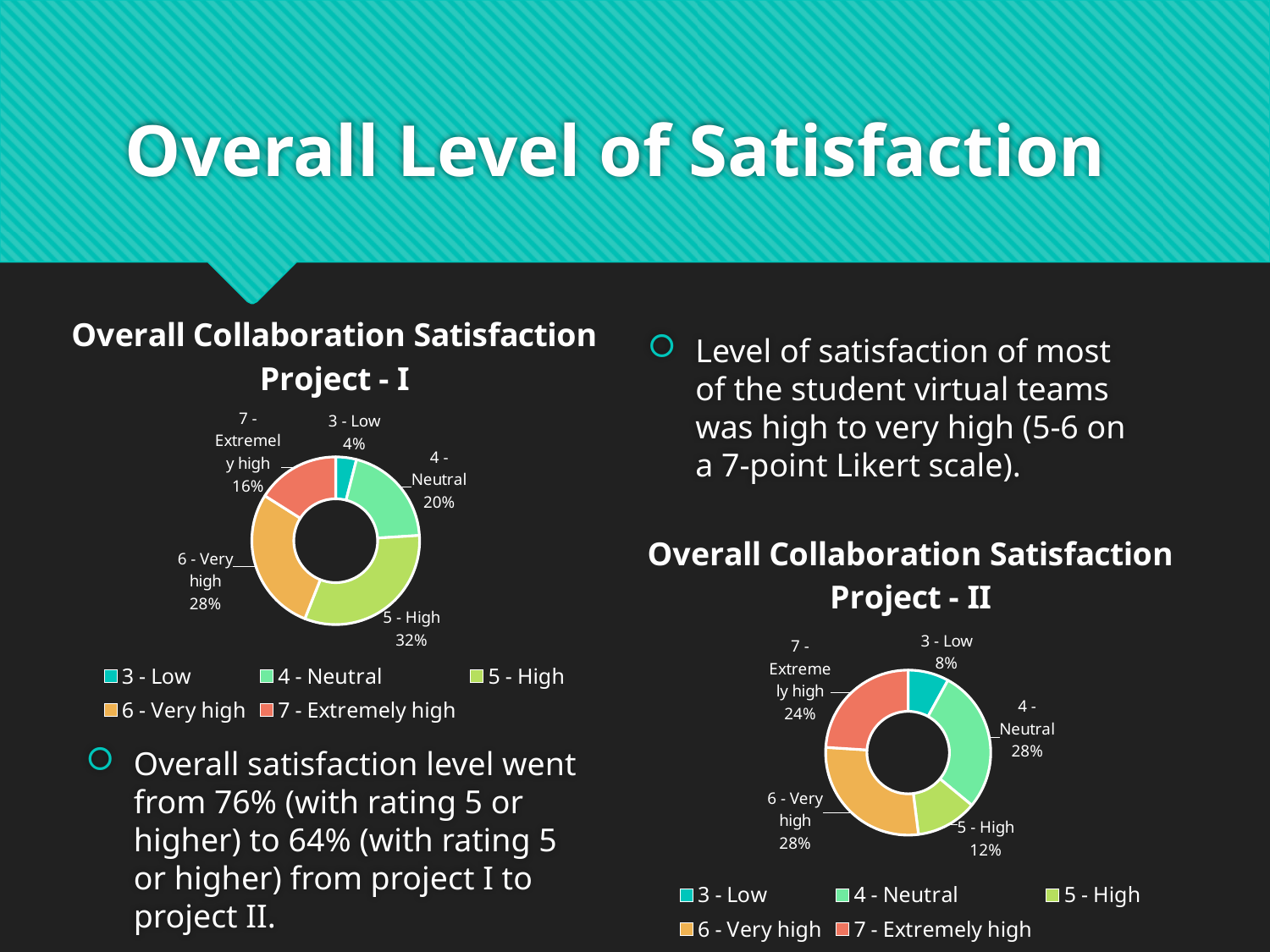
In the Overall Collaboration Satisfaction Project - I chart, what percentage is shown for 7 - Extremely high? 16% In the Overall Collaboration Satisfaction Project - I chart, which is larger: 6 - Very high or 4 - Neutral? 6 - Very high In the Overall Collaboration Satisfaction Project - I chart, what percentage is shown for 5 - High? 32% What kind of chart is the Overall Collaboration Satisfaction Project - I chart? doughnut chart In the Overall Collaboration Satisfaction Project - II chart, what colour is the 7 - Extremely high slice? red/salmon In the Overall Collaboration Satisfaction Project - I chart, which category has the smallest share? 3 - Low In the Overall Collaboration Satisfaction Project - II chart, what is the difference in percentage points between 7 - Extremely high and 5 - High? 12 In the Overall Collaboration Satisfaction Project - I chart, which category has the largest share? 5 - High In the Overall Collaboration Satisfaction Project - II chart, which category has the smallest share? 3 - Low In the Overall Collaboration Satisfaction Project - II chart, what percentage is shown for 5 - High? 12% In the Overall Collaboration Satisfaction Project - II chart, what percentage is shown for 4 - Neutral? 28% How many categories does the Overall Collaboration Satisfaction Project - II chart show? 5